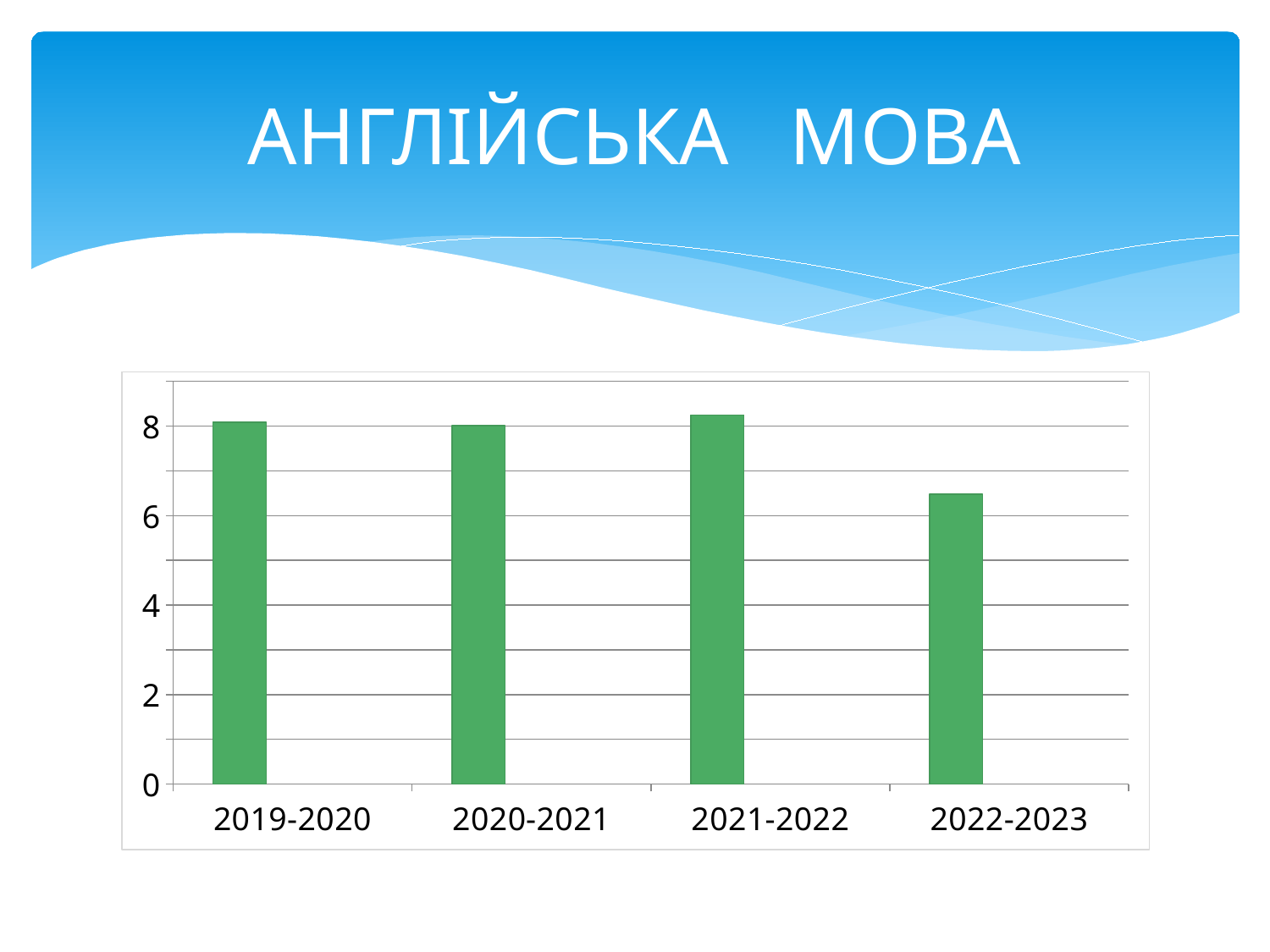
What colour are the bars in the chart? green Which school year has the lowest bar in the chart? 2022-2023 Does the value fall or rise from 2021-2022 to 2022-2023? fall Is the value for 2019-2020 greater or less than 6? greater Which is larger, the value for 2021-2022 or the value for 2022-2023? 2021-2022 Is the value for 2021-2022 greater or less than 8? greater What kind of chart is shown on the slide? bar chart How many categories (school years) are shown on the x axis of the chart? 4 Is the value for 2022-2023 greater or less than 6? greater What is the title shown at the top of the slide above the chart? АНГЛІЙСЬКА МОВА Which is larger, the value for 2019-2020 or the value for 2022-2023? 2019-2020